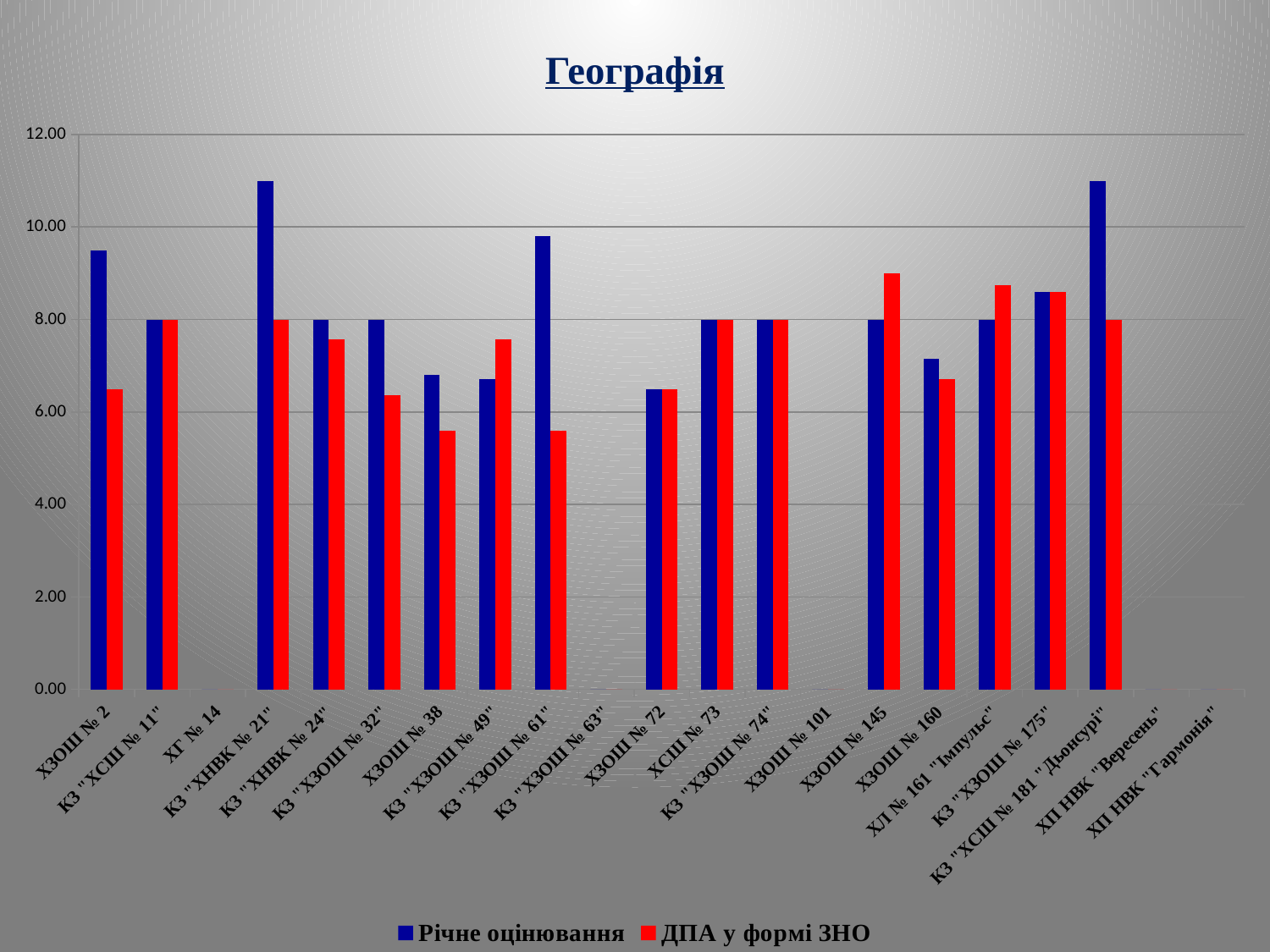
Is the value of Річне оцінювання for КЗ "ХНВК № 21" greater or less than 10.00? greater What is the title of the chart? Географія What is the value of Річне оцінювання for КЗ "ХСШ № 11"? 8.00 For ХЗОШ № 145, which is larger: Річне оцінювання or ДПА у формі ЗНО? ДПА у формі ЗНО Which category has the highest value for ДПА у формі ЗНО? ХЗОШ № 145 How many series does the legend list? 2 Is the value of Річне оцінювання for ХЗОШ № 2 greater or less than 8.00? greater For КЗ "ХЗОШ № 61", which is larger: Річне оцінювання or ДПА у формі ЗНО? Річне оцінювання What is the value of ДПА у формі ЗНО for ХСШ № 73? 8.00 Is the value of ДПА у формі ЗНО for ХЗОШ № 38 greater or less than 6.00? less How many categories are shown on the x axis? 21 What kind of chart is shown on the slide? bar chart